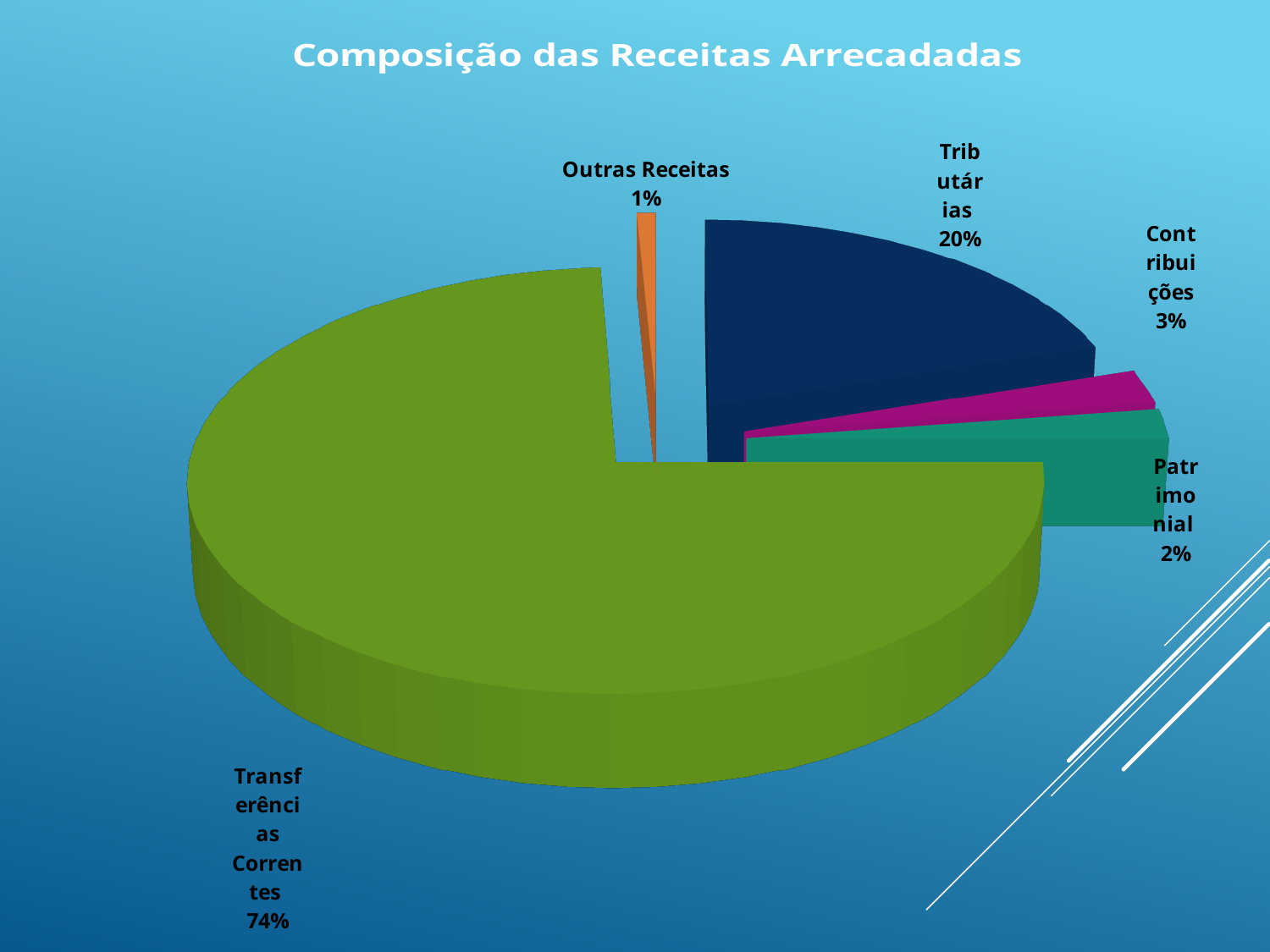
Which category has the largest slice of the pie? Transferências Correntes What is the title of the chart? Composição das Receitas Arrecadadas What share of the pie does Tributárias represent? 20% What is the value shown for Patrimonial? 2% What is the value shown for Outras Receitas? 1% What is the difference between the shares of Transferências Correntes and Tributárias? 54% What kind of chart is shown on the slide? pie chart How many slices does the pie chart have? 5 Which category has the smallest slice of the pie? Outras Receitas Which is larger, the share for Contribuições or the share for Patrimonial? Contribuições What share of the pie does Transferências Correntes represent? 74% What is the value shown for Contribuições? 3%